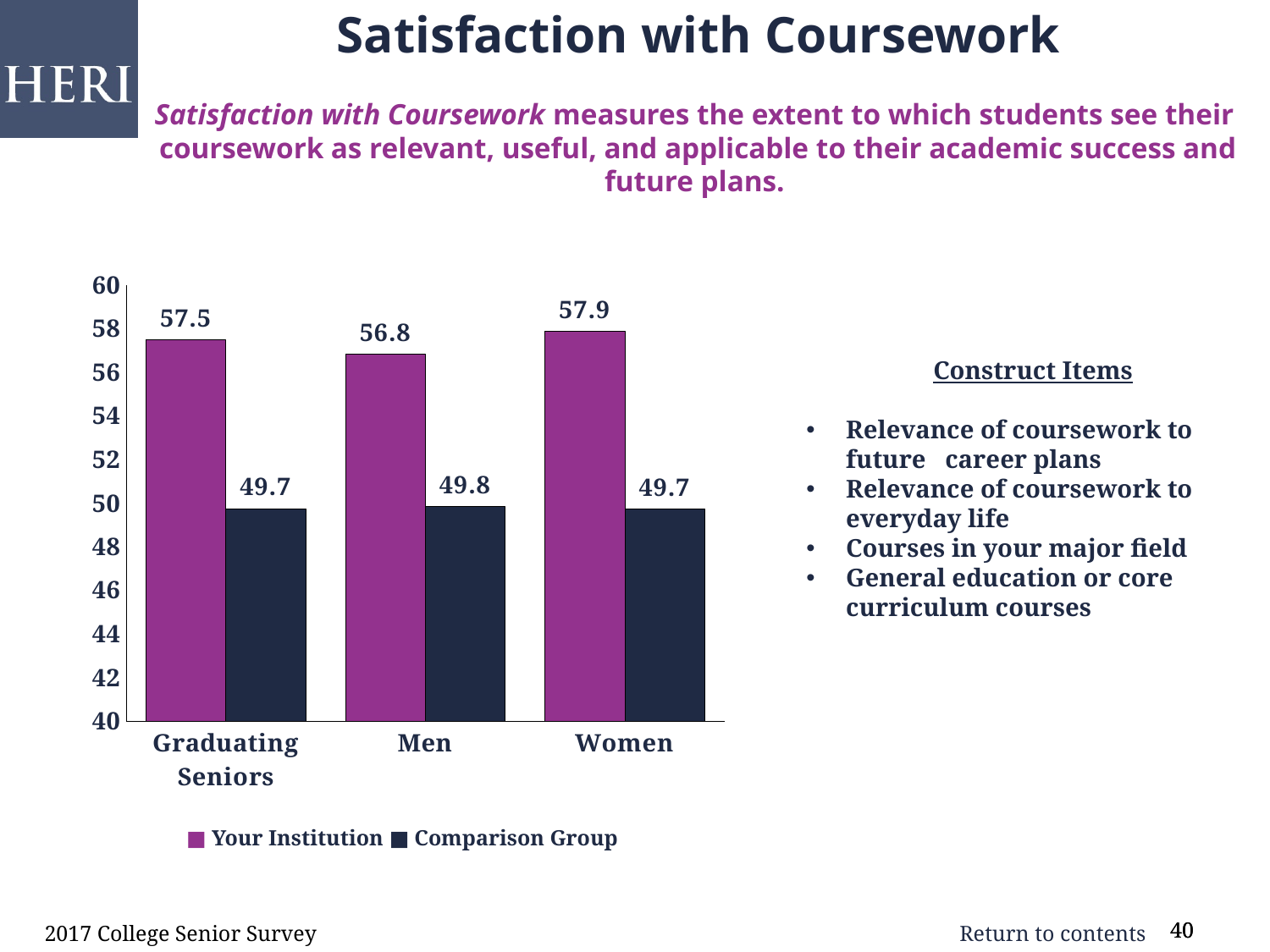
How many series does the legend list? 2 What is the difference between Your Institution and Comparison Group for Women? 8.2 Is the value for Comparison Group for Women greater or less than 50? less For Men, which is larger: Your Institution or Comparison Group? Your Institution How many categories are shown on the x axis? 3 Which category has the lowest value for Your Institution? Men What is the value for Comparison Group for Men? 49.8 What is the value for Your Institution for Women? 57.9 Which category has the highest value for Your Institution? Women What is the difference between Your Institution and Comparison Group for Graduating Seniors? 7.8 What is the value for Your Institution for Graduating Seniors? 57.5 What kind of chart is shown on the slide? bar chart